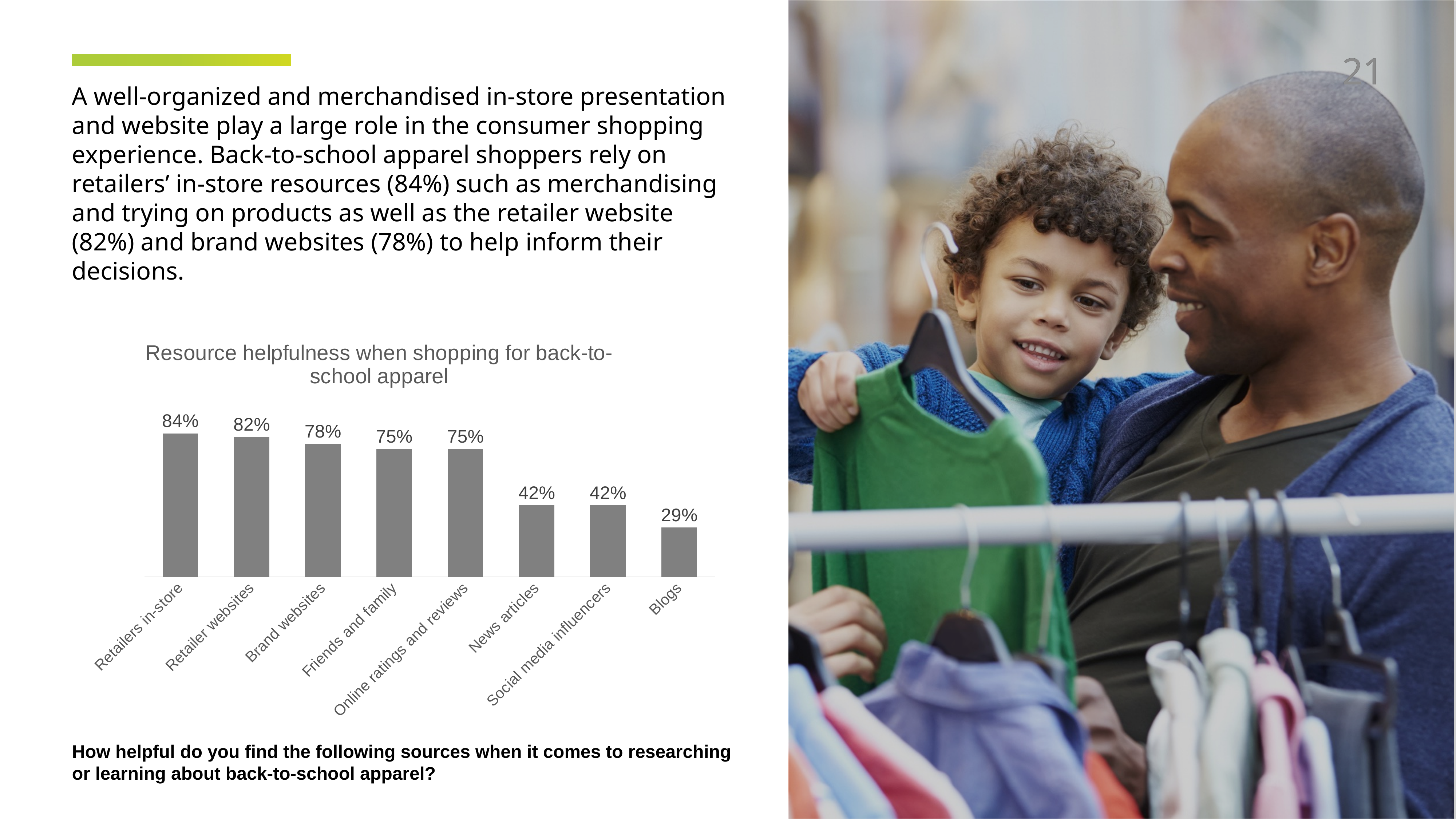
Which category has the lowest value? Blogs Which category has the highest value? Retailers in-store What is the difference between the values for Retailer websites and News articles? 40% Which is larger, the value for Friends and family or the value for Blogs? Friends and family What is the value for Retailers in-store? 84% What is the value for Blogs? 29% How many categories are shown in the chart? 8 What kind of chart is shown on the slide? Bar chart What is the title of the chart? Resource helpfulness when shopping for back-to-school apparel What is the value for Brand websites? 78% What is the value for Social media influencers? 42% Do the values rise or fall from left to right along the x axis? Fall